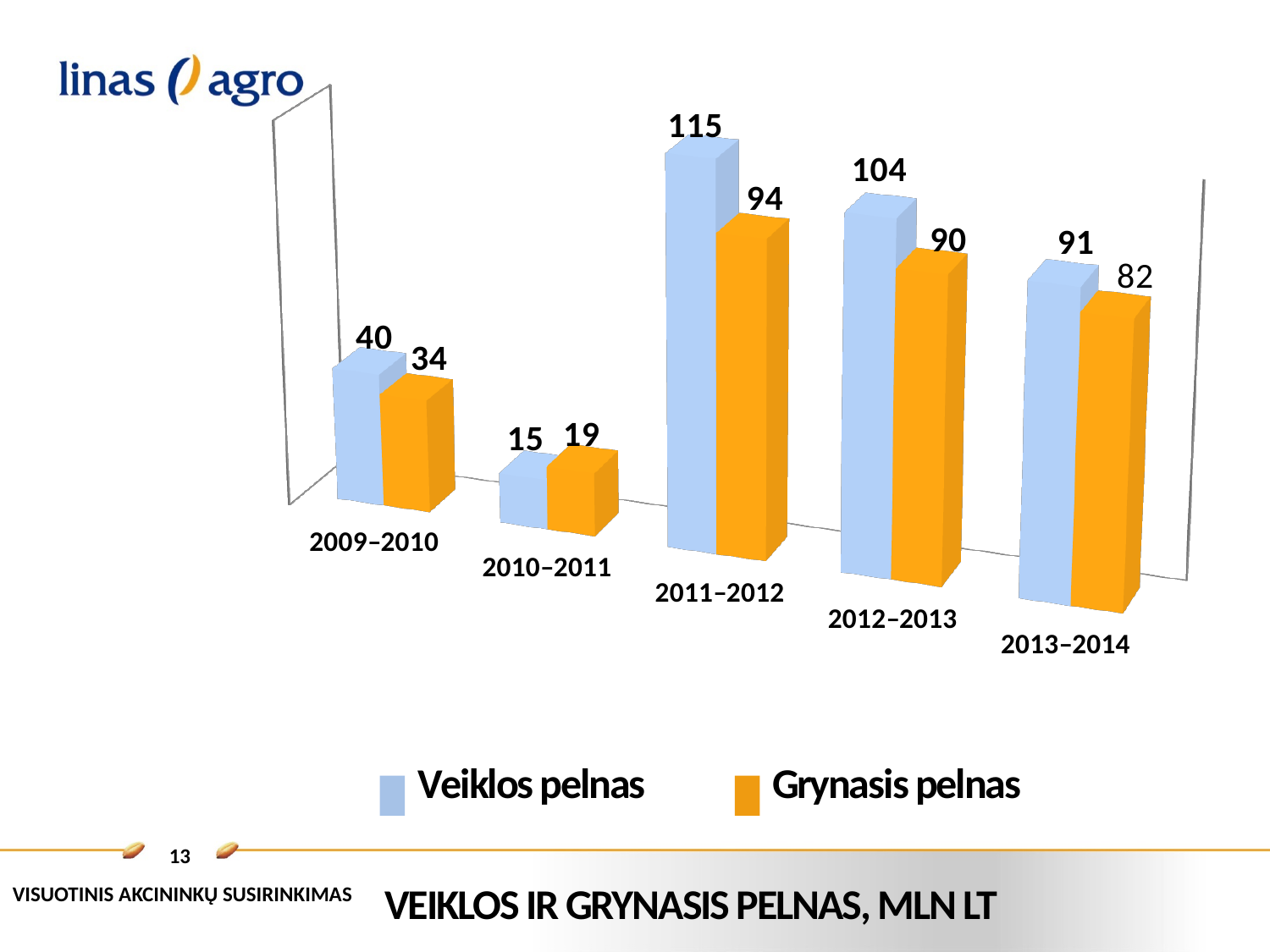
What is the value of Veiklos pelnas for 2011–2012? 115 What is the value of Grynasis pelnas for 2013–2014? 82 Does Veiklos pelnas rise or fall from 2011–2012 to 2013–2014? Fall What kind of chart is shown on the slide? Bar chart What is the value of Grynasis pelnas for 2009–2010? 34 Which period has the lowest Grynasis pelnas? 2010–2011 Which period has the highest Veiklos pelnas? 2011–2012 How many periods are shown on the x axis? 5 What is the difference between Veiklos pelnas and Grynasis pelnas in 2012–2013? 14 What colour represents Grynasis pelnas in the legend? Orange How many series does the legend list? 2 Which is larger in 2010–2011, Veiklos pelnas or Grynasis pelnas? Grynasis pelnas